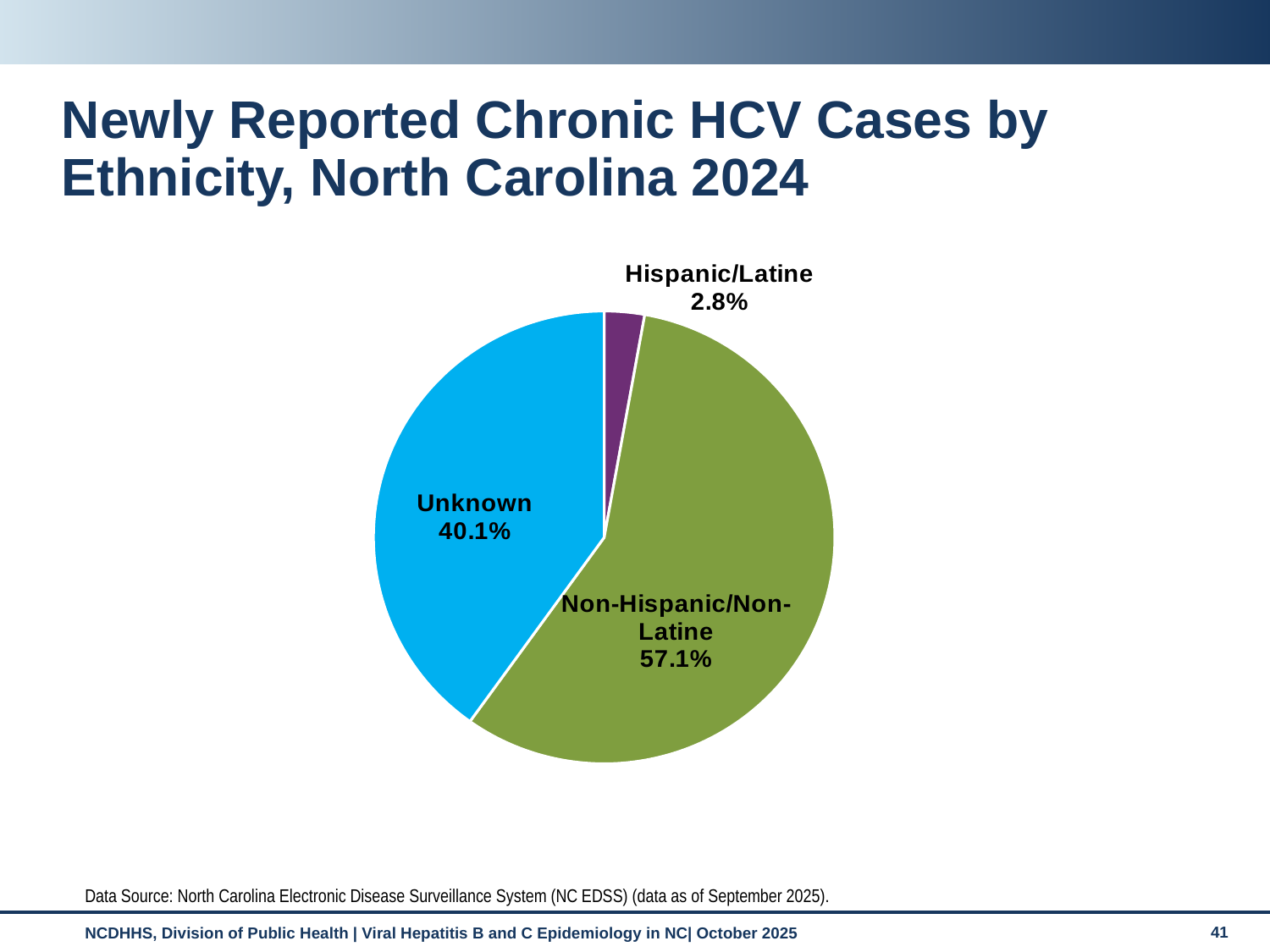
Which is larger, the Unknown slice or the Hispanic/Latine slice? Unknown What colour is the Unknown slice? blue What kind of chart is shown on the slide? pie chart How many slices does the pie chart have? 3 What is the difference in percentage points between the Unknown and Hispanic/Latine slices? 37.3 What is the difference in percentage points between the Non-Hispanic/Non-Latine and Unknown slices? 17.0 Which ethnicity category has the smallest share of cases? Hispanic/Latine What percentage of cases is Hispanic/Latine? 2.8% What percentage of newly reported chronic HCV cases is Non-Hispanic/Non-Latine? 57.1% Which ethnicity category has the largest share of cases? Non-Hispanic/Non-Latine What is the title of the chart on the slide? Newly Reported Chronic HCV Cases by Ethnicity, North Carolina 2024 What percentage of cases has Unknown ethnicity? 40.1%